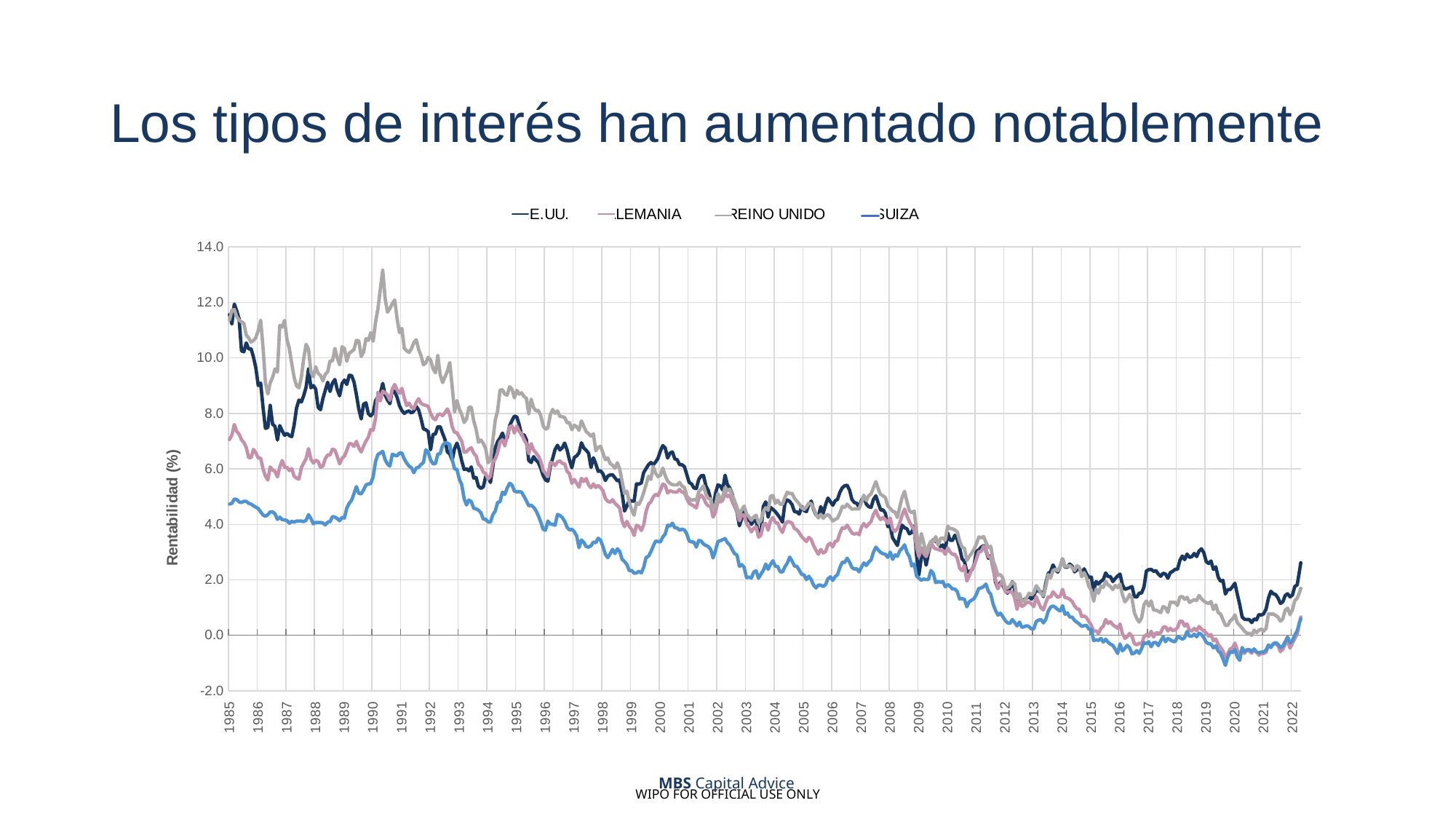
Is the value for E.UU. at the start of 1985 greater or less than 10.0? greater Which series has the lowest value in 1985? SUIZA How many series does the legend list? 4 Overall, do the values rise or fall from 1985 to 2022? fall Is the final value for E.UU. in 2022 greater or less than 2.0? greater Which series reaches the highest value anywhere on the chart? REINO UNIDO Is the value for SUIZA in 1985 greater or less than 6.0? less What kind of chart is shown on the slide? line chart In 2018, which is higher, E.UU. or REINO UNIDO? E.UU. How many year labels are shown on the x axis? 38 What is the title of the y axis? Rentabilidad (%)